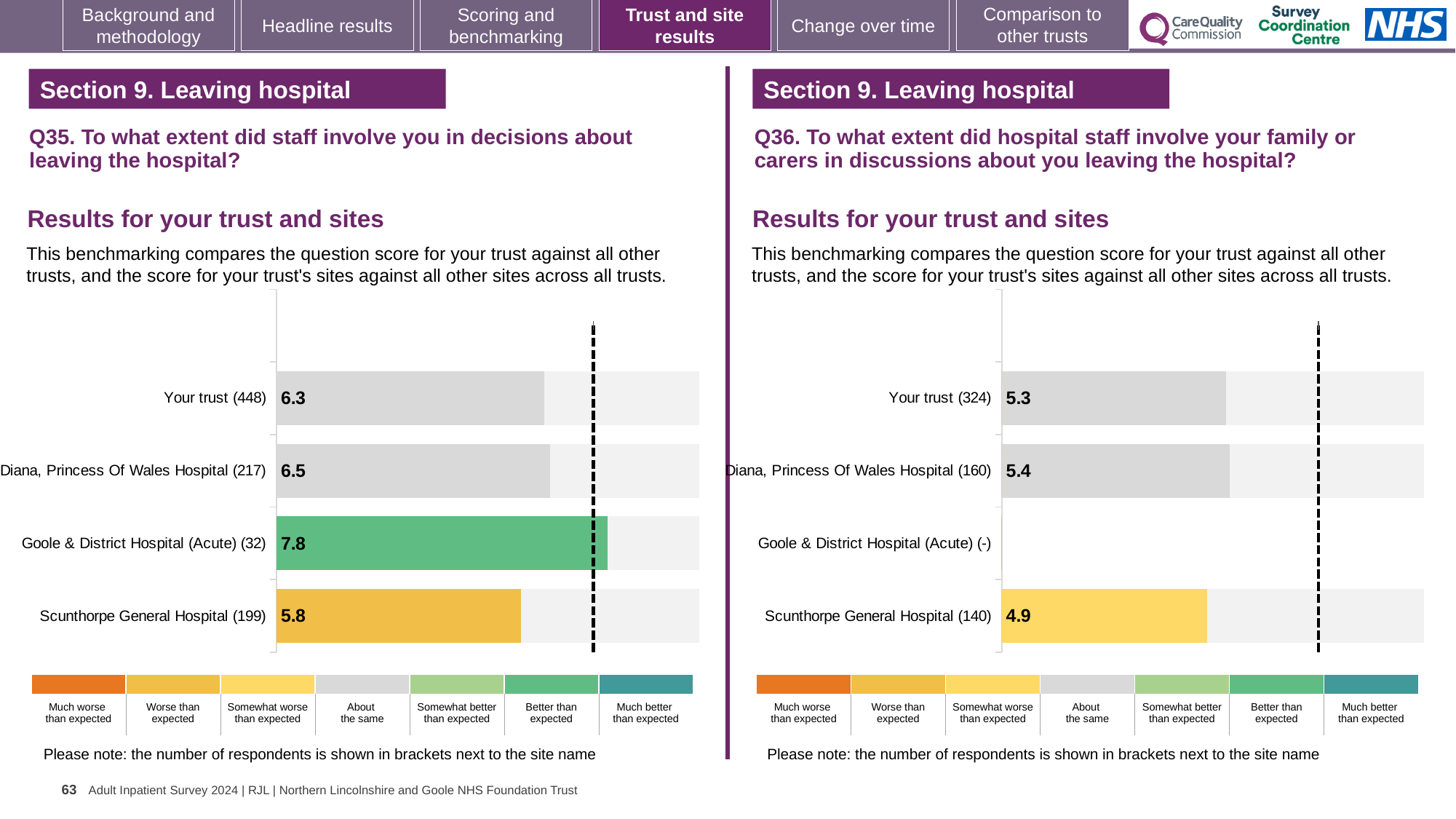
In the Q36 chart on the right, what is the difference between the scores for Diana, Princess Of Wales Hospital and Your trust? 0.1 In the Q35 chart on the left, what is the difference between the scores for Goole & District Hospital (Acute) and Scunthorpe General Hospital? 2.0 In the Q36 chart on the right, what is the score for Your trust? 5.3 In the Q35 chart on the left, how many bars are plotted? 4 In the Q36 chart on the right, which is larger: the score for Diana, Princess Of Wales Hospital or the score for Scunthorpe General Hospital? Diana, Princess Of Wales Hospital In the Q35 chart on the left, what is the score for Goole & District Hospital (Acute)? 7.8 In the Q36 chart on the right, what is the score for Scunthorpe General Hospital? 4.9 In the Q35 chart on the left, which benchmark category does the colour of the Goole & District Hospital (Acute) bar indicate? Better than expected In the Q35 chart on the left, which site has the highest score? Goole & District Hospital (Acute) In the Q35 chart on the left, which site has the lowest score? Scunthorpe General Hospital What kind of chart is used for the Q35 results on the left? Bar chart In the Q35 chart on the left, what is the score for Your trust? 6.3